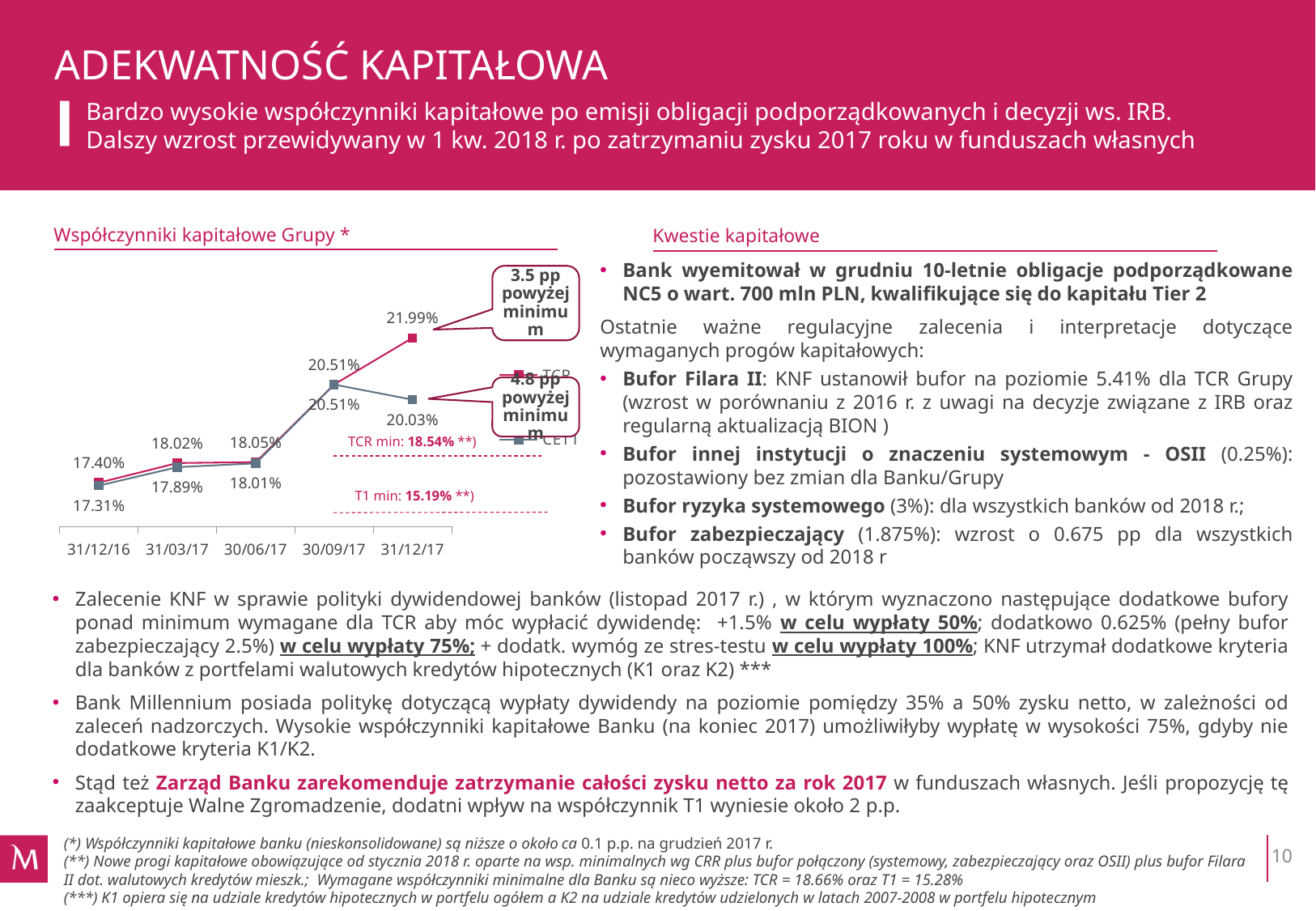
At which date is the TCR value highest? 31/12/17 Does the TCR value rise or fall from 31/12/16 to 31/12/17? Rises How many dates are shown on the x axis of the chart? 5 How many series does the chart plot? 2 What TCR minimum level is marked by the dashed line on the chart? 18.54% What is the CET1 value at 31/12/16? 17.31% At which date is the CET1 value lowest? 31/12/16 By how much did TCR increase from 30/09/17 to 31/12/17? 1.48 pp What is the CET1 value at 30/09/17? 20.51% At 31/12/17, which is larger: TCR or CET1? TCR What is the TCR value at 31/12/17? 21.99% What kind of chart is used to show the Group capital ratios? Line chart